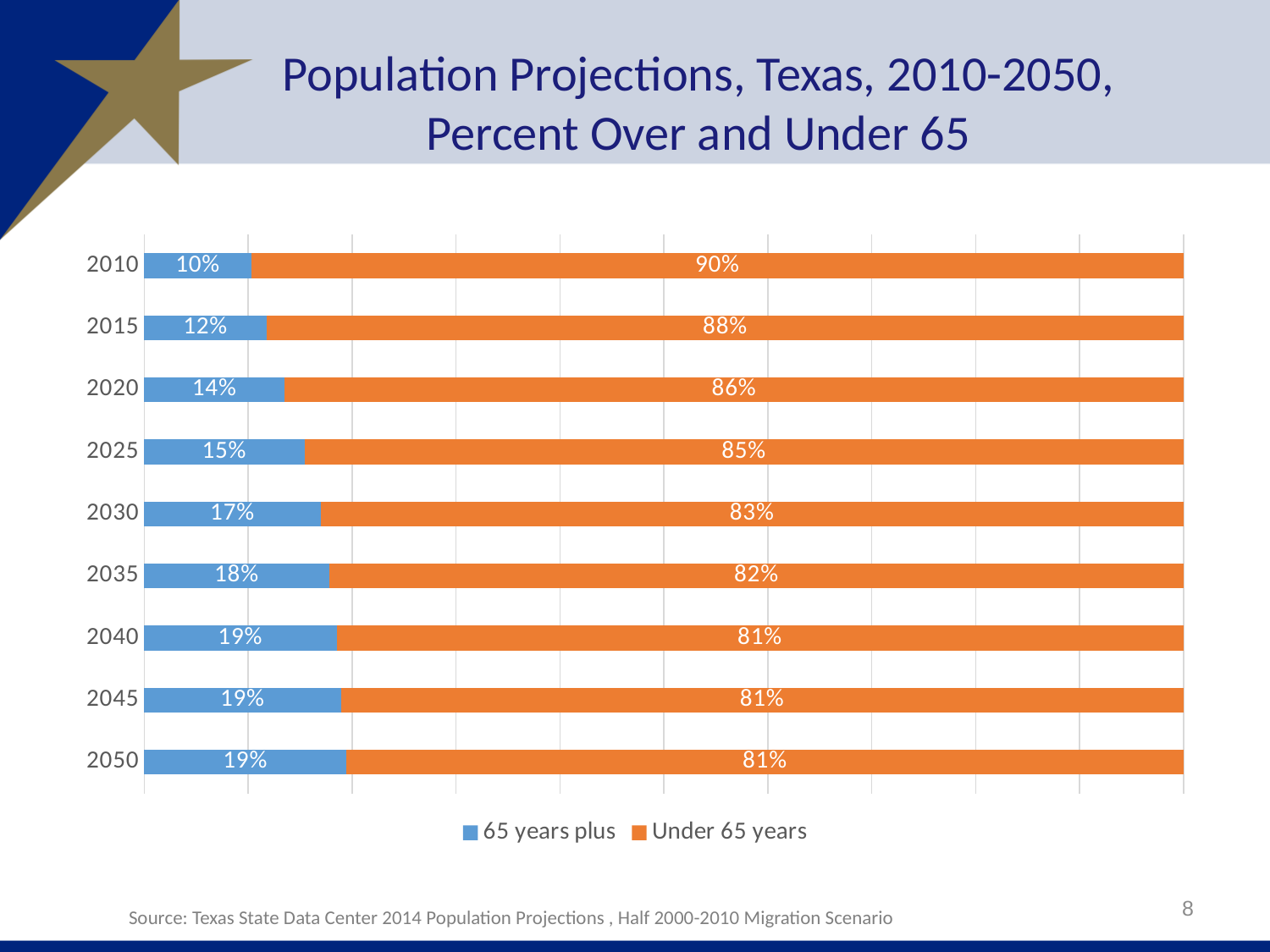
Does the '65 years plus' share rise or fall from 2010 to 2050? Rise What is the value for 'Under 65 years' in 2030? 83% What is the value for '65 years plus' in 2010? 10% What is the total of the stacked bar for 2025? 100% Which is larger, the '65 years plus' value for 2020 or for 2035? 2035 What is the difference between the 'Under 65 years' values for 2010 and 2050? 9% What kind of chart is shown on the slide? Stacked bar chart How many series does the legend list? 2 What is the value for '65 years plus' in 2050? 19% How many years are shown on the chart? 9 Which year has the lowest value for '65 years plus'? 2010 Which year has the highest value for 'Under 65 years'? 2010